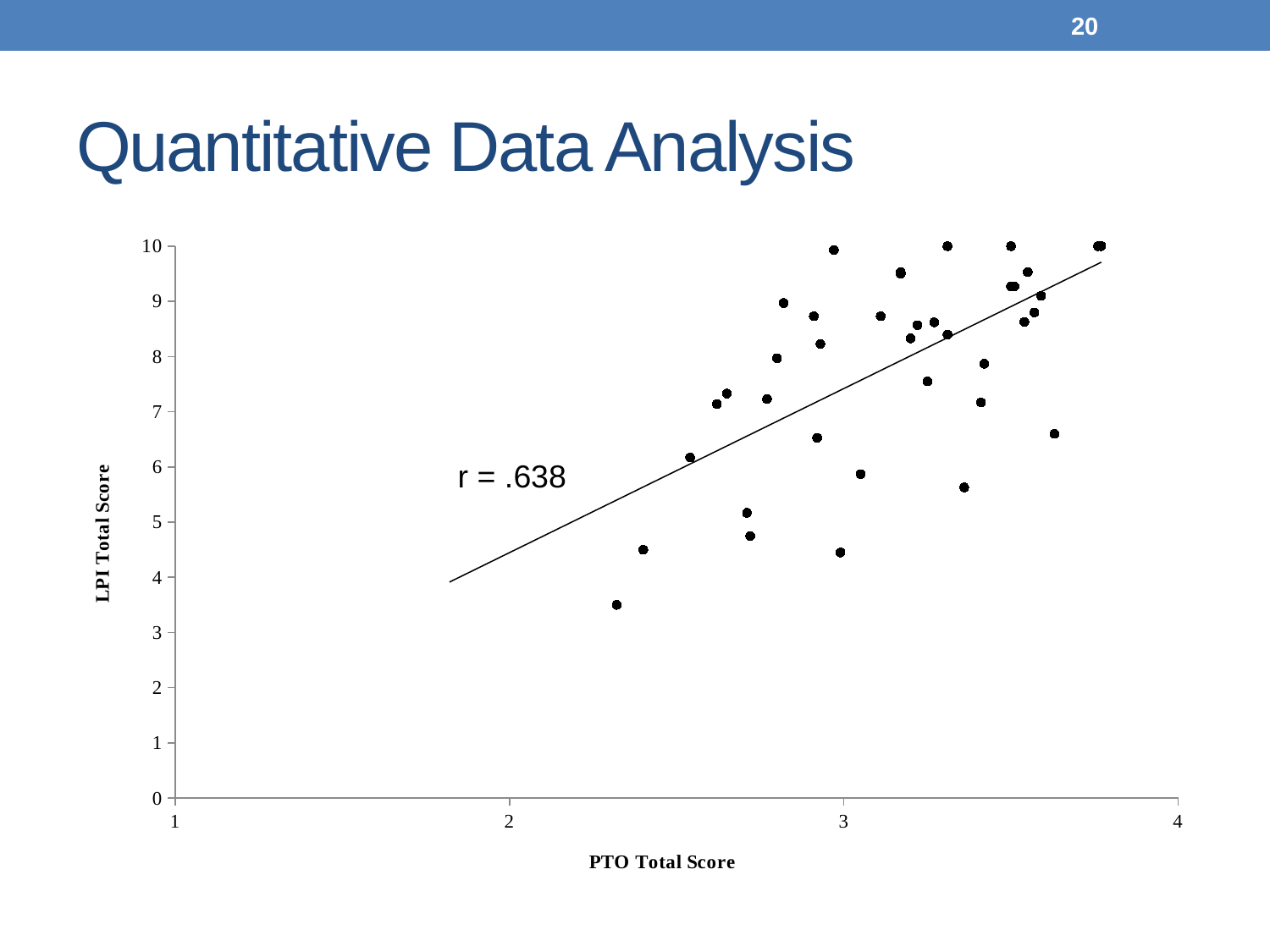
Does the trend line rise or fall as PTO Total Score increases? Rises What is the maximum value shown on the y axis? 10 What correlation coefficient is printed on the chart? r = .638 Is the lowest LPI Total Score plotted greater or less than 4? less What is the label of the x axis? PTO Total Score What kind of chart is shown on the slide? Scatter plot Is the smallest PTO Total Score plotted greater or less than 2? greater Is the highest LPI Total Score plotted greater or less than 9? greater Is the relationship between PTO Total Score and LPI Total Score positive or negative? Positive What is the label of the y axis? LPI Total Score What is the maximum value shown on the x axis? 4